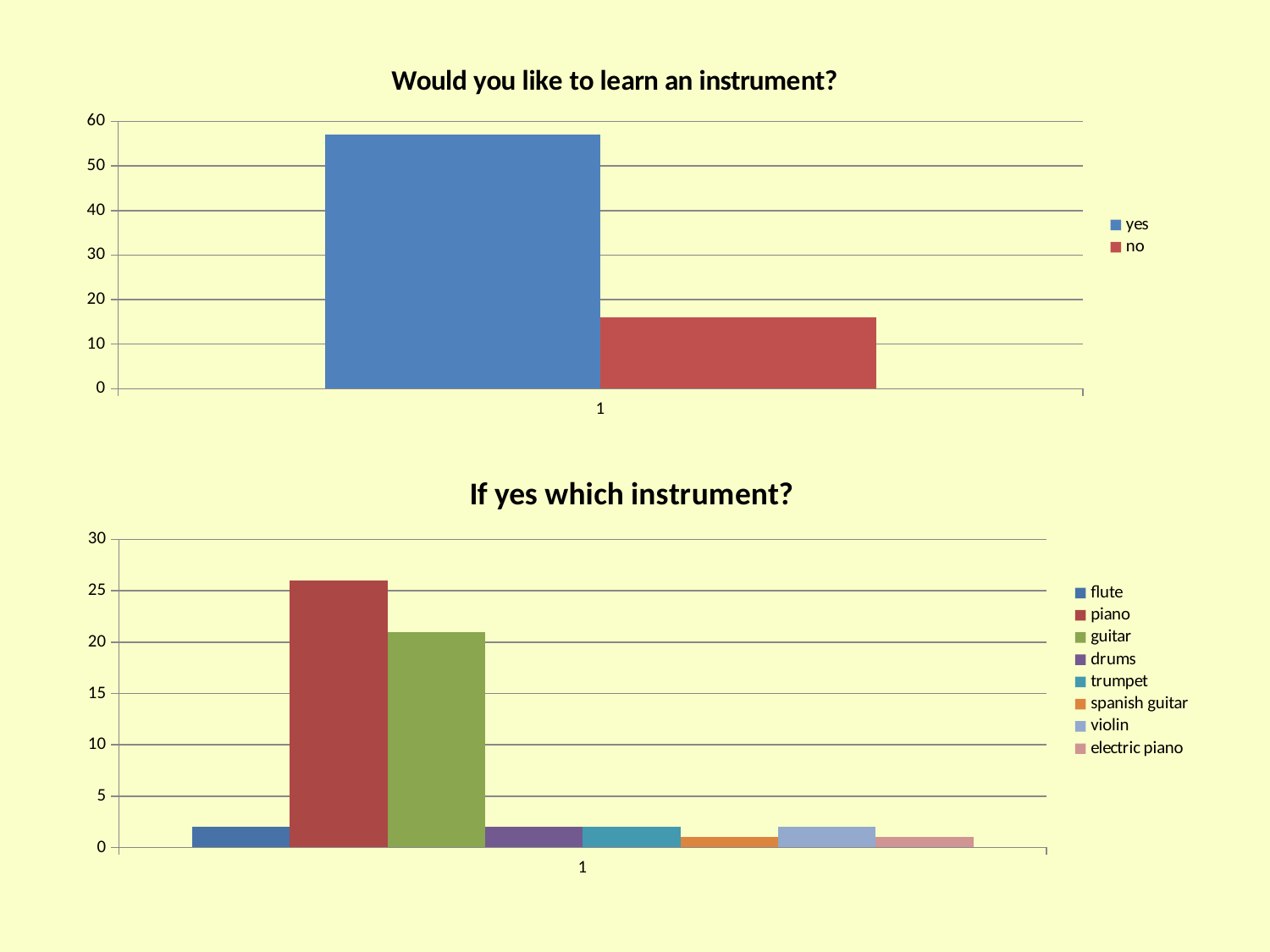
In the chart titled "If yes which instrument?", is the value for flute greater or less than 5? less In the chart titled "If yes which instrument?", what colour is the bar for piano? red In the chart titled "If yes which instrument?", is the value for guitar greater or less than 25? less In the chart titled "Would you like to learn an instrument?", how many series does the legend list? 2 In the chart titled "If yes which instrument?", is the value for piano greater or less than 20? greater In the chart titled "If yes which instrument?", which instrument has the highest value? piano In the chart titled "If yes which instrument?", how many instruments does the legend list? 8 In the chart titled "If yes which instrument?", which is larger, the value for piano or the value for guitar? piano What kind of chart is the chart titled "Would you like to learn an instrument?"? bar chart In the chart titled "Would you like to learn an instrument?", which response has the taller bar? yes